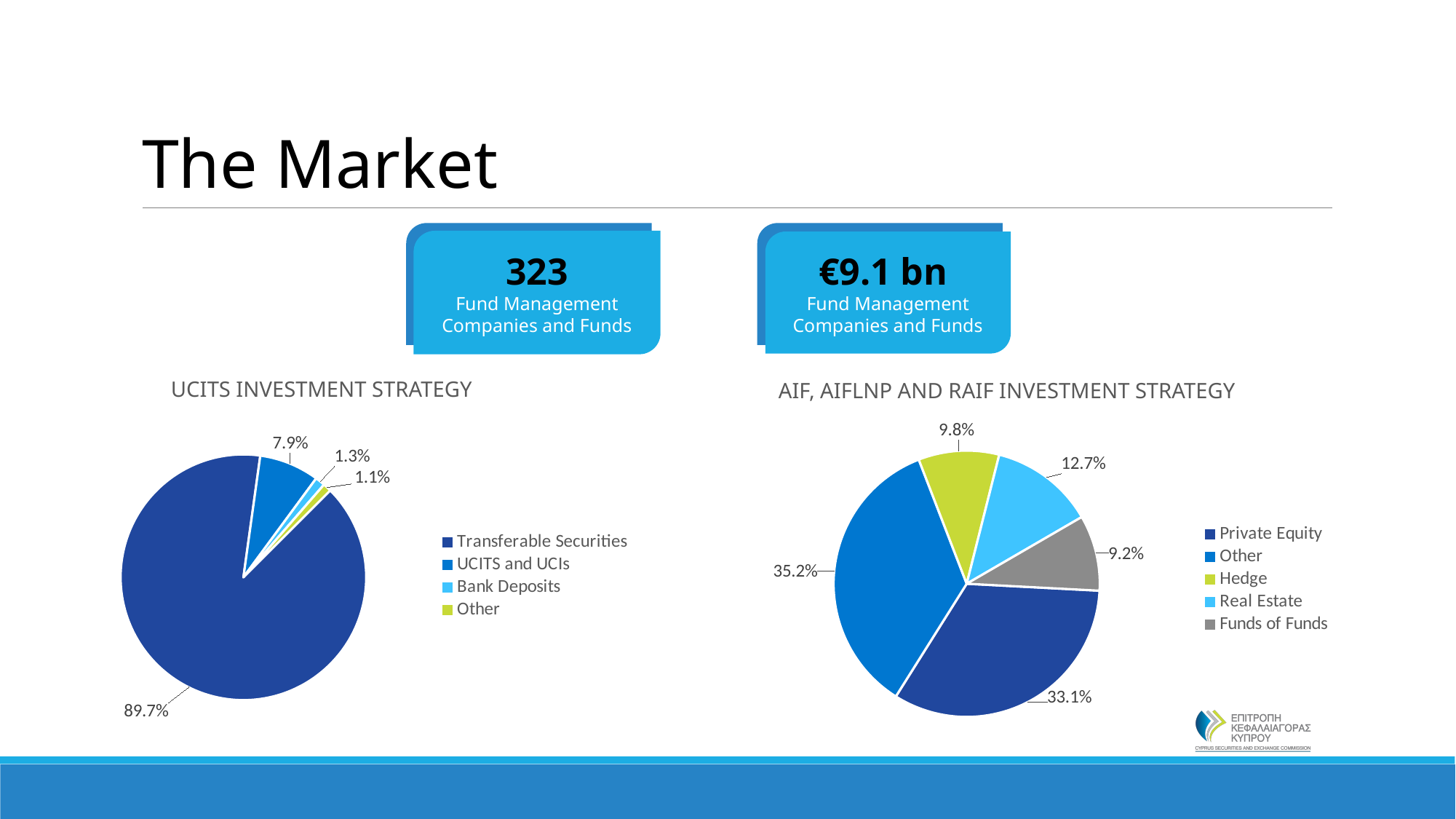
In the UCITS Investment Strategy pie chart, what share is Transferable Securities? 89.7% What type of chart is the UCITS Investment Strategy chart? Pie chart In the AIF, AIFLNP and RAIF Investment Strategy pie chart, which category has the smallest share? Funds of Funds In the AIF, AIFLNP and RAIF Investment Strategy pie chart, what share is Hedge? 9.8% In the UCITS Investment Strategy pie chart, which category has the smallest share? Other In the AIF, AIFLNP and RAIF Investment Strategy pie chart, what is the difference between the Other share and the Private Equity share? 2.1% In the AIF, AIFLNP and RAIF Investment Strategy pie chart, how many categories does the legend list? 5 In the UCITS Investment Strategy pie chart, what is the difference between the Bank Deposits share and the Other share? 0.2% In the AIF, AIFLNP and RAIF Investment Strategy pie chart, which category has the largest share? Other In the AIF, AIFLNP and RAIF Investment Strategy pie chart, what share is Real Estate? 12.7% In the UCITS Investment Strategy pie chart, what share is UCITS and UCIs? 7.9% In the UCITS Investment Strategy pie chart, how many categories does the legend list? 4